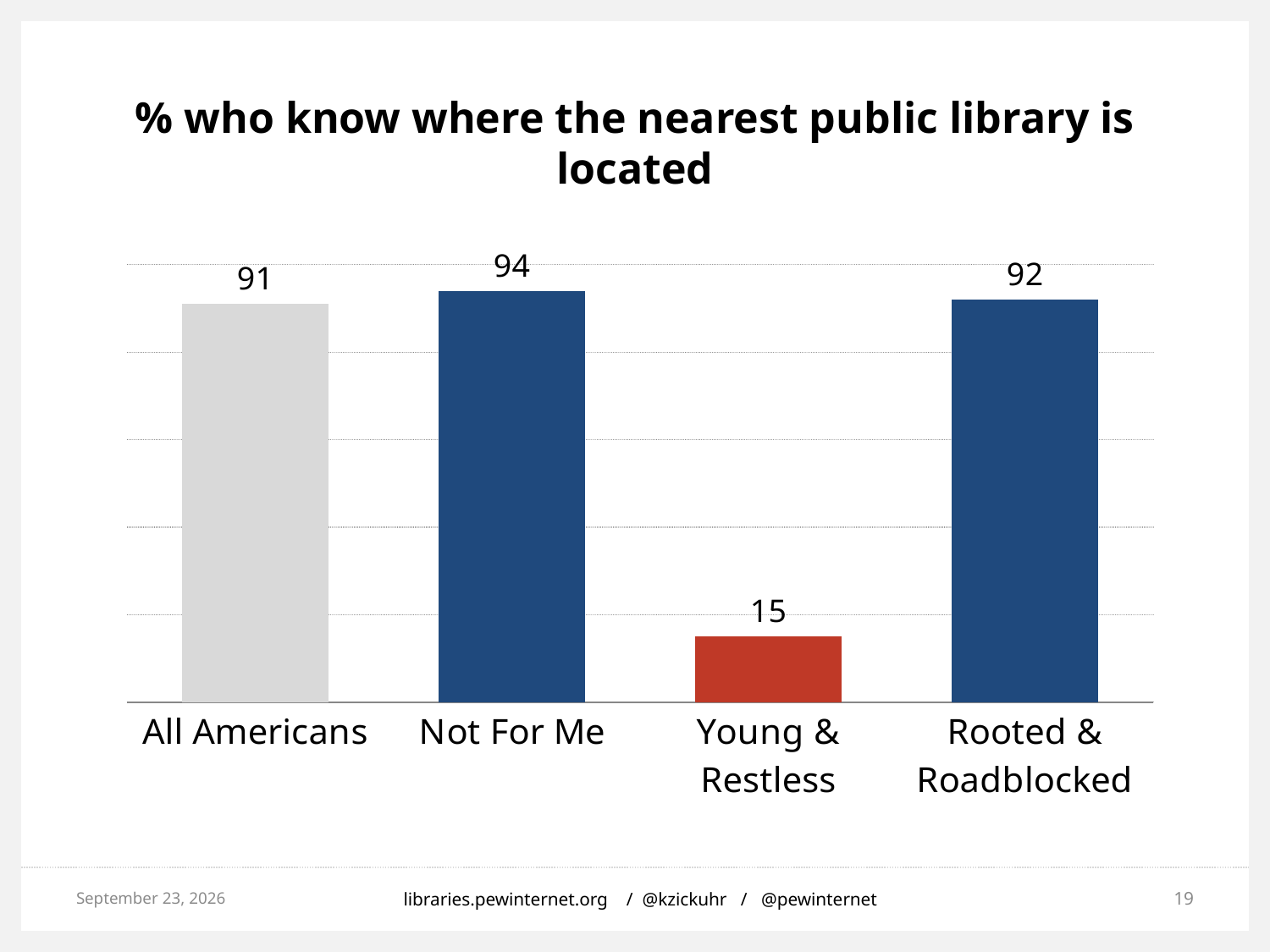
What is the value for Not For Me? 94 What is the title of the chart? % who know where the nearest public library is located How many categories are shown in the chart? 4 What is the value for All Americans? 91 What is the value for Young & Restless? 15 Which category has the highest value? Not For Me What is the difference between the values for Not For Me and Young & Restless? 79 What is the difference between the values for Rooted & Roadblocked and All Americans? 1 What kind of chart is shown on the slide? Bar chart Which is larger, the value for All Americans or the value for Young & Restless? All Americans Which category has the lowest value? Young & Restless What is the value for Rooted & Roadblocked? 92